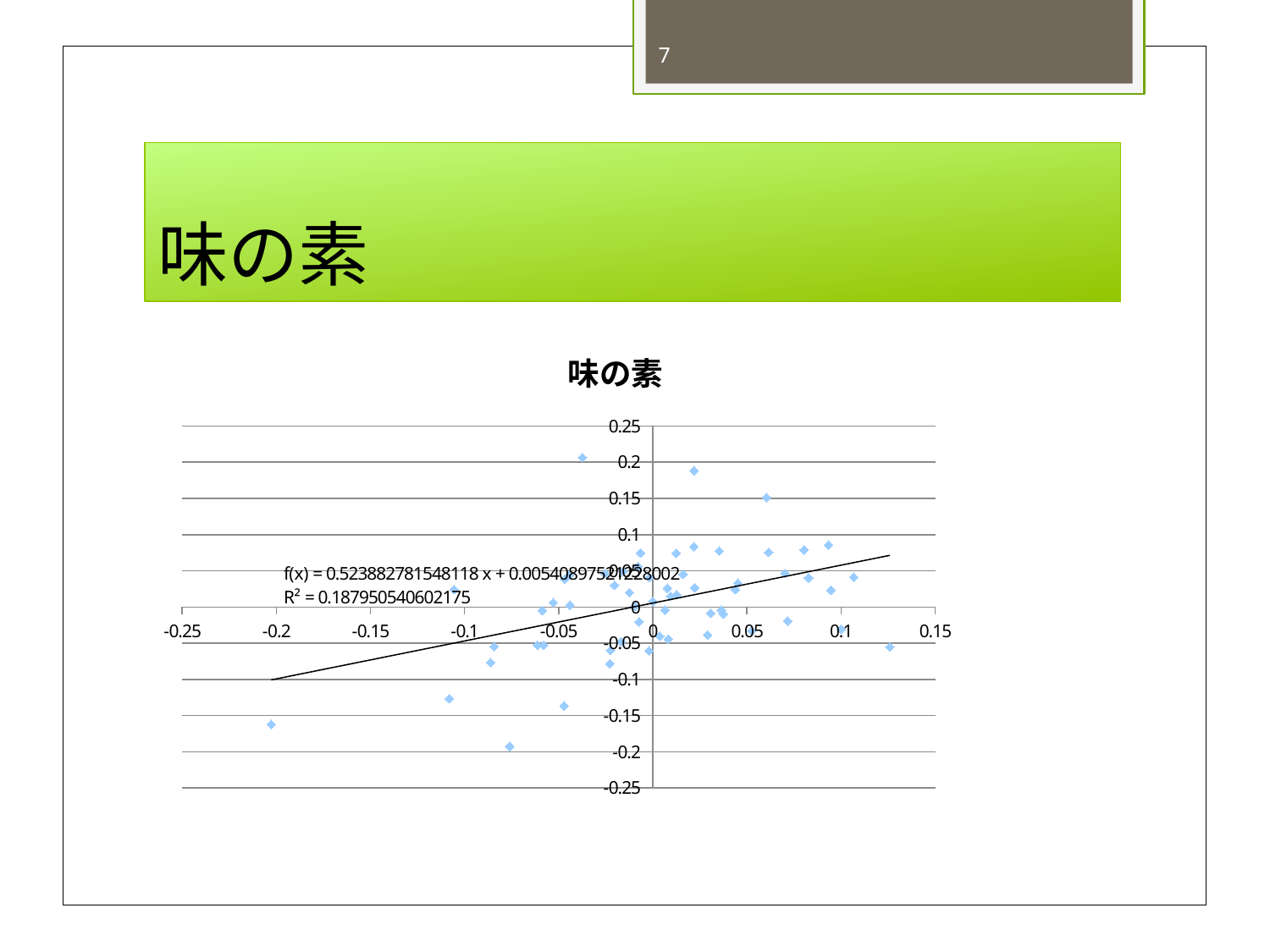
What R² value is displayed on the chart? 0.187950540602175 What is the maximum value shown on the vertical axis? 0.25 Does the fitted trendline rise or fall from left to right? rise Is the lowest plotted y value greater or less than -0.15? less What is the title of the chart? 味の素 What is the slope of the fitted line shown in the chart's equation? 0.523882781548118 What is the leftmost tick value on the horizontal axis? -0.25 Is the highest plotted y value greater or less than 0.15? greater What is the rightmost tick value on the horizontal axis? 0.15 What kind of chart is shown on the slide? scatter chart